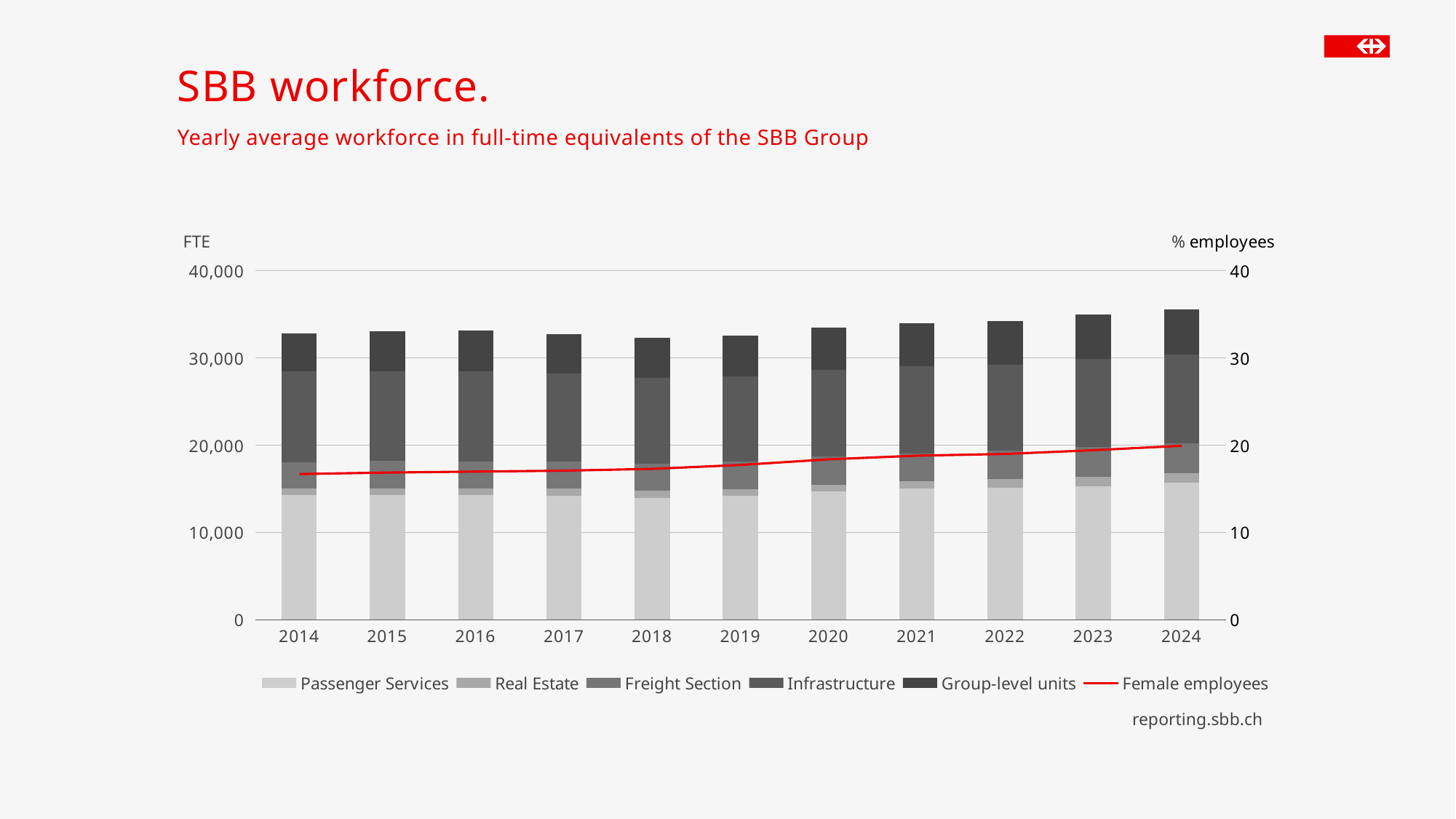
How many years are shown on the x axis of the chart? 11 Which series is drawn as a red line in the chart? Female employees Is the total workforce bar for 2018 greater or less than 40,000 FTE? less How many series does the chart's legend list? 6 Is the Female employees value for 2014 greater or less than 20%? less Is the Passenger Services segment for 2014 greater or less than 10,000 FTE? greater What kind of chart is shown on the slide? A stacked bar chart with a line Which year has the highest total workforce bar? 2024 What is the label of the left vertical axis? FTE Does the Female employees line rise or fall from 2014 to 2024? rises Which is larger, the total workforce bar for 2024 or for 2014? 2024